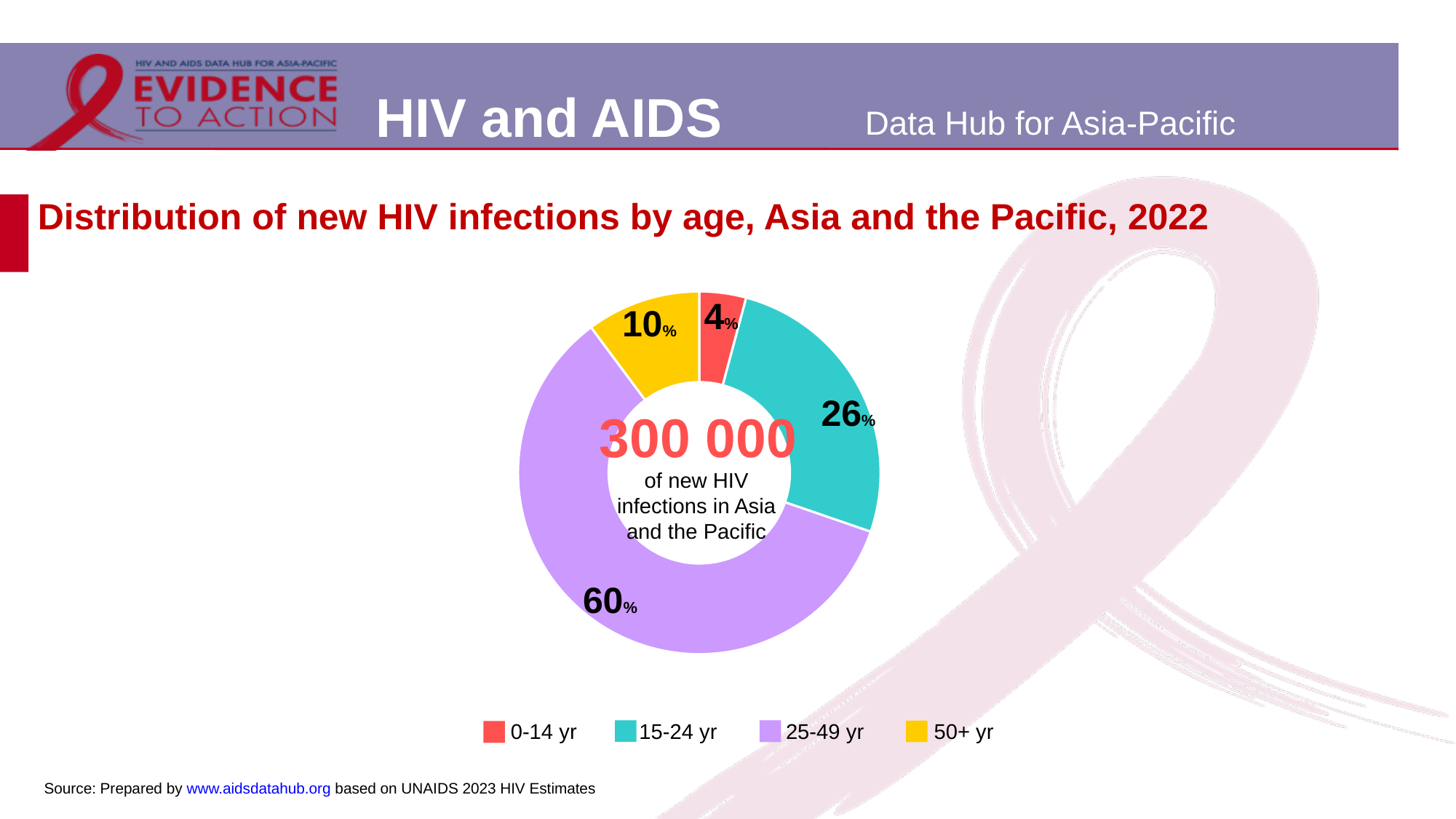
What share of new HIV infections is attributed to the 0-14 yr age group? 4% Which age group accounts for the largest share of new HIV infections? 25-49 yr What is the difference in percentage points between the 25-49 yr and 15-24 yr shares? 34 What share of new HIV infections is attributed to the 25-49 yr age group? 60% What total number of new HIV infections is shown in the centre of the chart? 300 000 What colour represents the 50+ yr age group in the chart? Yellow How many age groups are shown in the chart? 4 What share of new HIV infections is attributed to the 15-24 yr age group? 26% What kind of chart is used on this slide? Doughnut (pie) chart Which age group accounts for the smallest share of new HIV infections? 0-14 yr Which age group has a larger share of new HIV infections, 50+ yr or 15-24 yr? 15-24 yr What share of new HIV infections is attributed to the 50+ yr age group? 10%